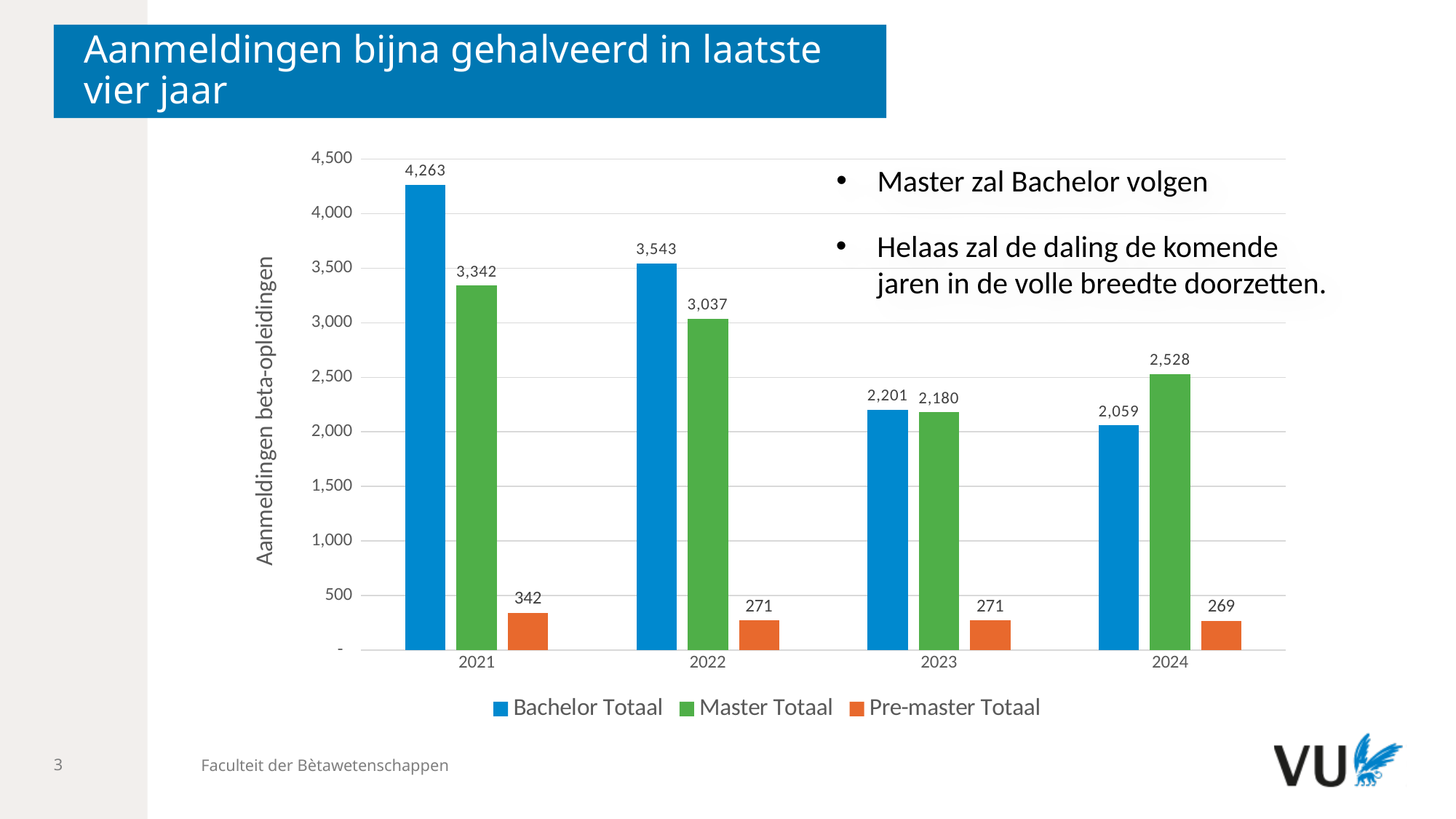
In which year is the Pre-master Totaal value lowest? 2024 How many years are shown on the x axis? 4 What is the Master Totaal value for 2024? 2,528 How many series does the legend list? 3 What is the difference between the Bachelor Totaal values for 2021 and 2024? 2,204 What kind of chart is shown on the slide? Bar chart Does the Bachelor Totaal value rise or fall from 2021 to 2024? Fall What is the Bachelor Totaal value for 2021? 4,263 Which is larger in 2024: Bachelor Totaal or Master Totaal? Master Totaal What is the label of the vertical axis? Aanmeldingen beta-opleidingen In which year is the Bachelor Totaal value highest? 2021 What is the Pre-master Totaal value for 2022? 271